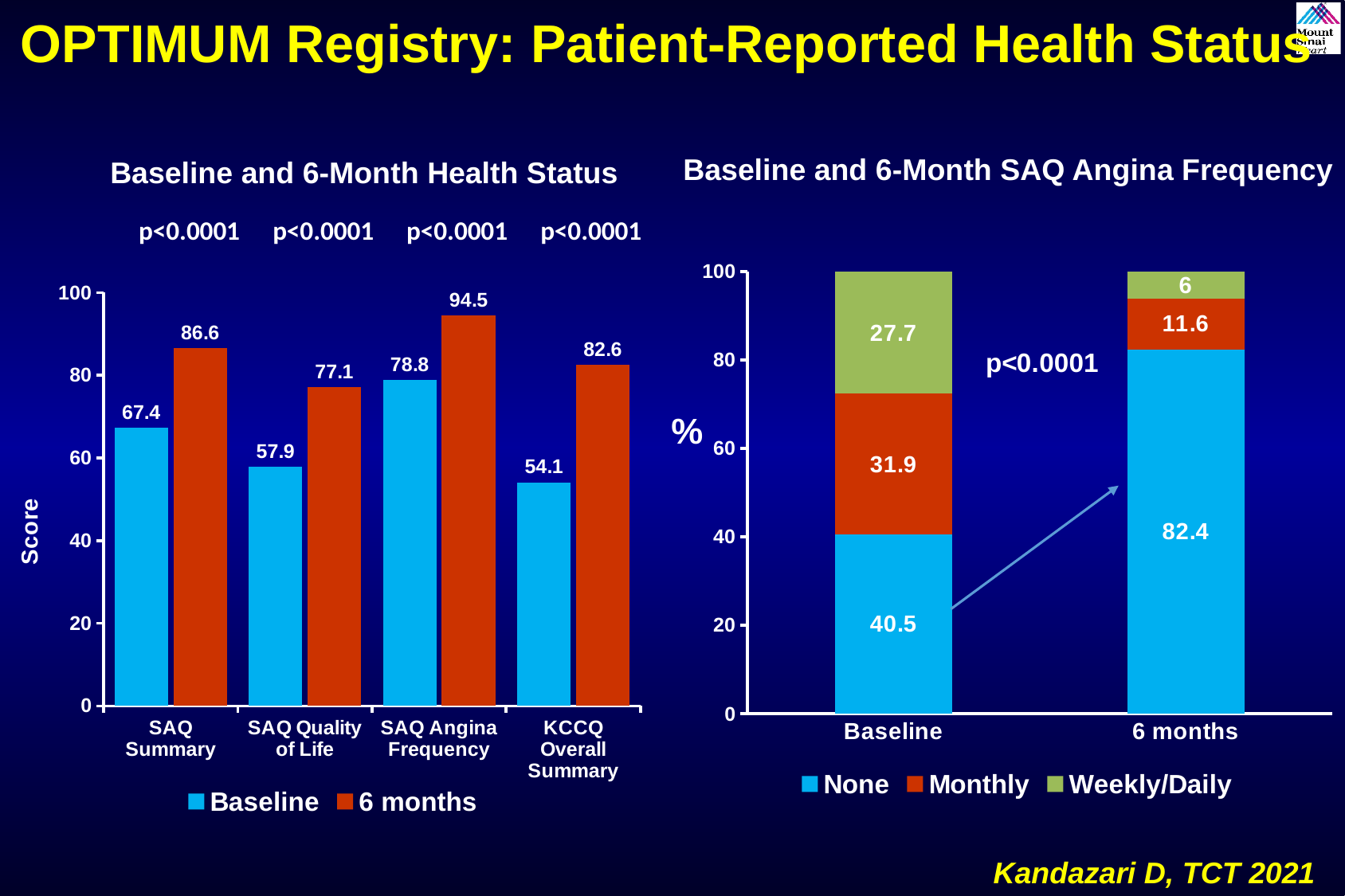
In the 'Baseline and 6-Month Health Status' chart, which is larger for KCCQ Overall Summary: the Baseline value or the 6 months value? 6 months In the 'Baseline and 6-Month Health Status' chart, what is the Baseline value for SAQ Summary? 67.4 In the 'Baseline and 6-Month Health Status' chart, what is the 6 months value for SAQ Angina Frequency? 94.5 In the 'Baseline and 6-Month SAQ Angina Frequency' chart, what is the None value at 6 months? 82.4 In the 'Baseline and 6-Month Health Status' chart, which category has the lowest Baseline value? KCCQ Overall Summary What kind of chart is the 'Baseline and 6-Month SAQ Angina Frequency' chart? Stacked bar chart In the 'Baseline and 6-Month SAQ Angina Frequency' chart, what is the total of the stacked bar at 6 months? 100 In the 'Baseline and 6-Month Health Status' chart, how many categories are shown on the x axis? 4 In the 'Baseline and 6-Month Health Status' chart, what is the difference between the 6 months and Baseline values for SAQ Quality of Life? 19.2 In the 'Baseline and 6-Month SAQ Angina Frequency' chart, what is the Monthly value at Baseline? 31.9 In the 'Baseline and 6-Month SAQ Angina Frequency' chart, how many series does the legend list? 3 In the 'Baseline and 6-Month Health Status' chart, how many series does the legend list? 2